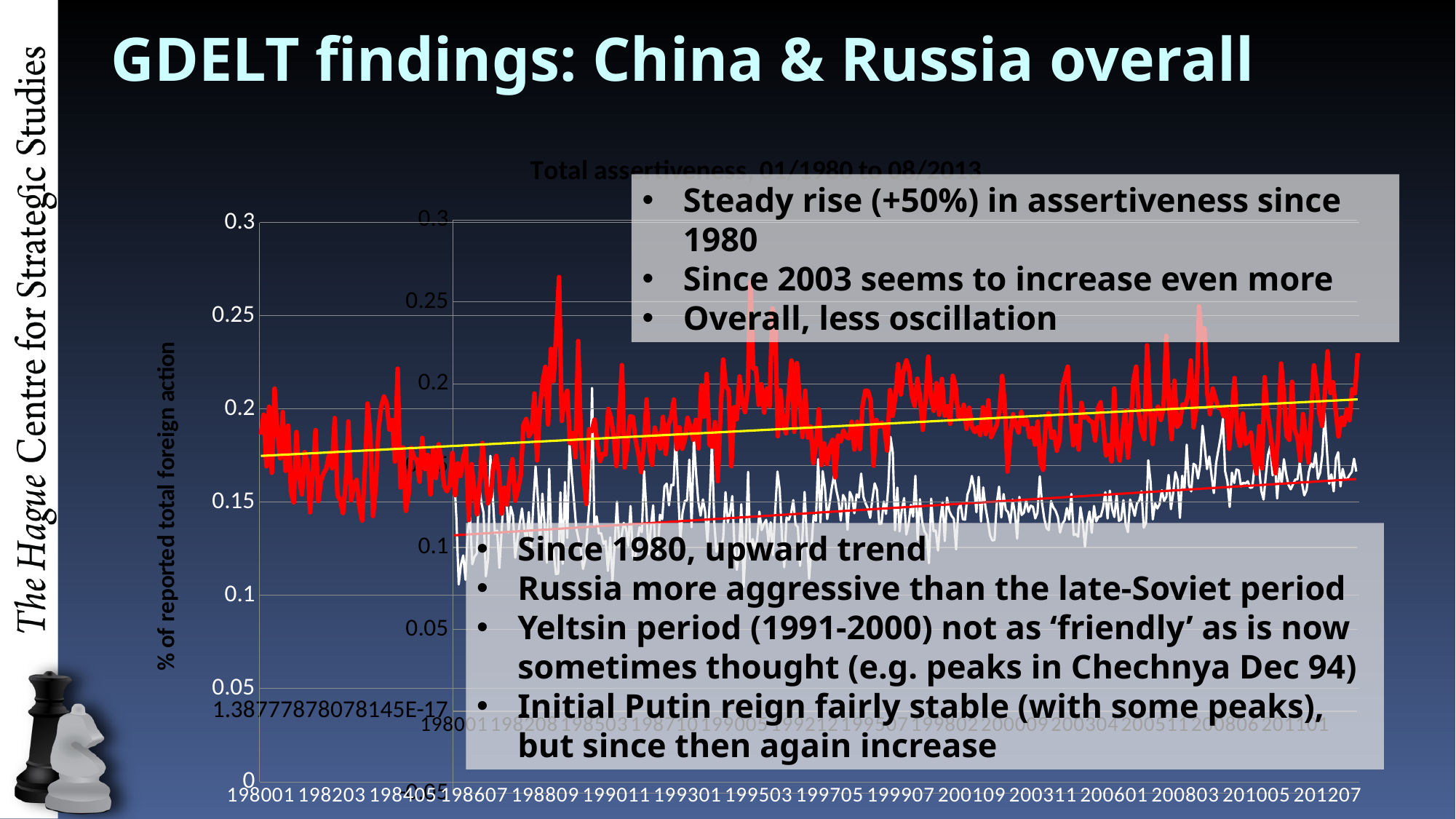
How many data series (coloured lines, excluding trend lines) are plotted on the chart? 2 Is the highest peak of the red series greater or less than 0.25 on the left axis? greater Is the lowest point of the red series greater or less than 0.1 on the left axis? greater What is the label on the vertical axis of the chart? % of reported total foreign action What is the title of the chart? Total assertiveness, 01/1980 to 08/2013 What is the maximum value shown on the left vertical axis? 0.3 Does the yellow trend line fitted to the red series rise or fall from left to right? rise What kind of chart is shown on the slide? line chart Is the highest peak of the red series greater or less than 0.3 on the left axis? less Does the red trend line fitted to the white series rise or fall from left to right? rise What is the first x-axis label on the left axis of the chart? 198001 What is the last x-axis label on the bottom axis of the chart? 201207